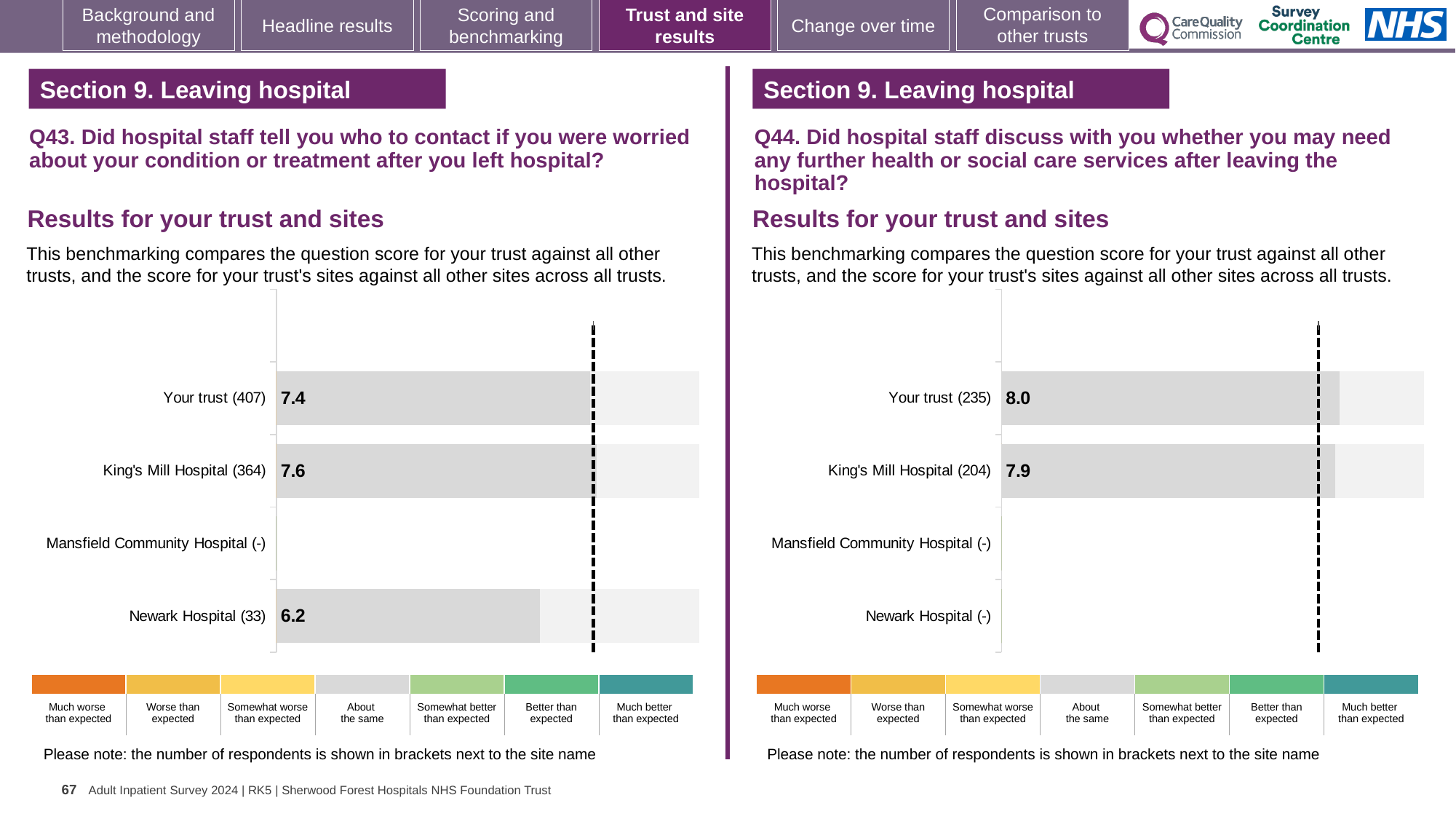
What kind of chart is used on the Q43 chart (left)? Bar chart On the Q43 chart (left), which has the higher score, Your trust or Newark Hospital? Your trust On the Q44 chart (right), what is the score for Your trust? 8.0 On the Q44 chart (right), what is the score for King's Mill Hospital? 7.9 On the Q43 chart (left), what is the score for King's Mill Hospital? 7.6 On the Q43 chart (left), what is the difference between the King's Mill Hospital score and the Newark Hospital score? 1.4 On the Q43 chart (left), what is the score for Your trust? 7.4 On the Q43 chart (left), how many site rows are listed on the vertical axis? 4 On the Q44 chart (right), what is the difference between the Your trust score and the King's Mill Hospital score? 0.1 On the Q43 chart (left), which site has the lowest score? Newark Hospital On the Q43 chart (left), what is the score for Newark Hospital? 6.2 On the Q44 chart (right), how many respondents are shown in brackets for King's Mill Hospital? 204